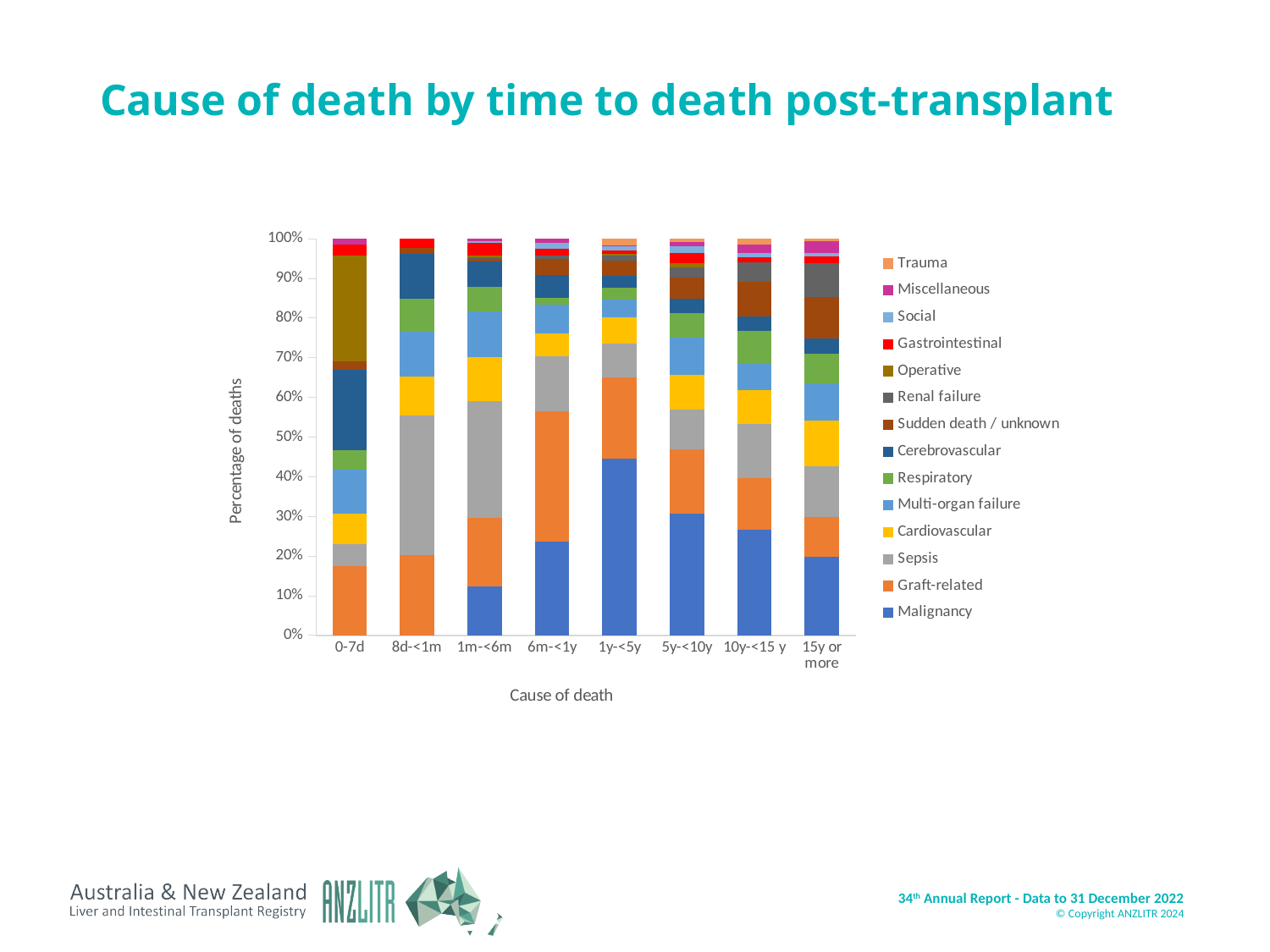
Which time-period category has the largest Operative share? 0-7d What is the label on the vertical axis? Percentage of deaths Is the Malignancy share for 1y-<5y greater or less than 40%? greater Is the Malignancy share for 0-7d greater or less than 10%? less What kind of chart is shown on the slide? Stacked bar chart Is the Malignancy share for 10y-<15 y greater or less than 30%? less How many time-period categories are shown on the x axis? 8 What is the title of the chart? Cause of death by time to death post-transplant Which has the larger Malignancy share, 1y-<5y or 15y or more? 1y-<5y What is the total of the stacked bar for 0-7d? 100% How many series does the legend list? 14 Which time-period category has the largest Malignancy share? 1y-<5y